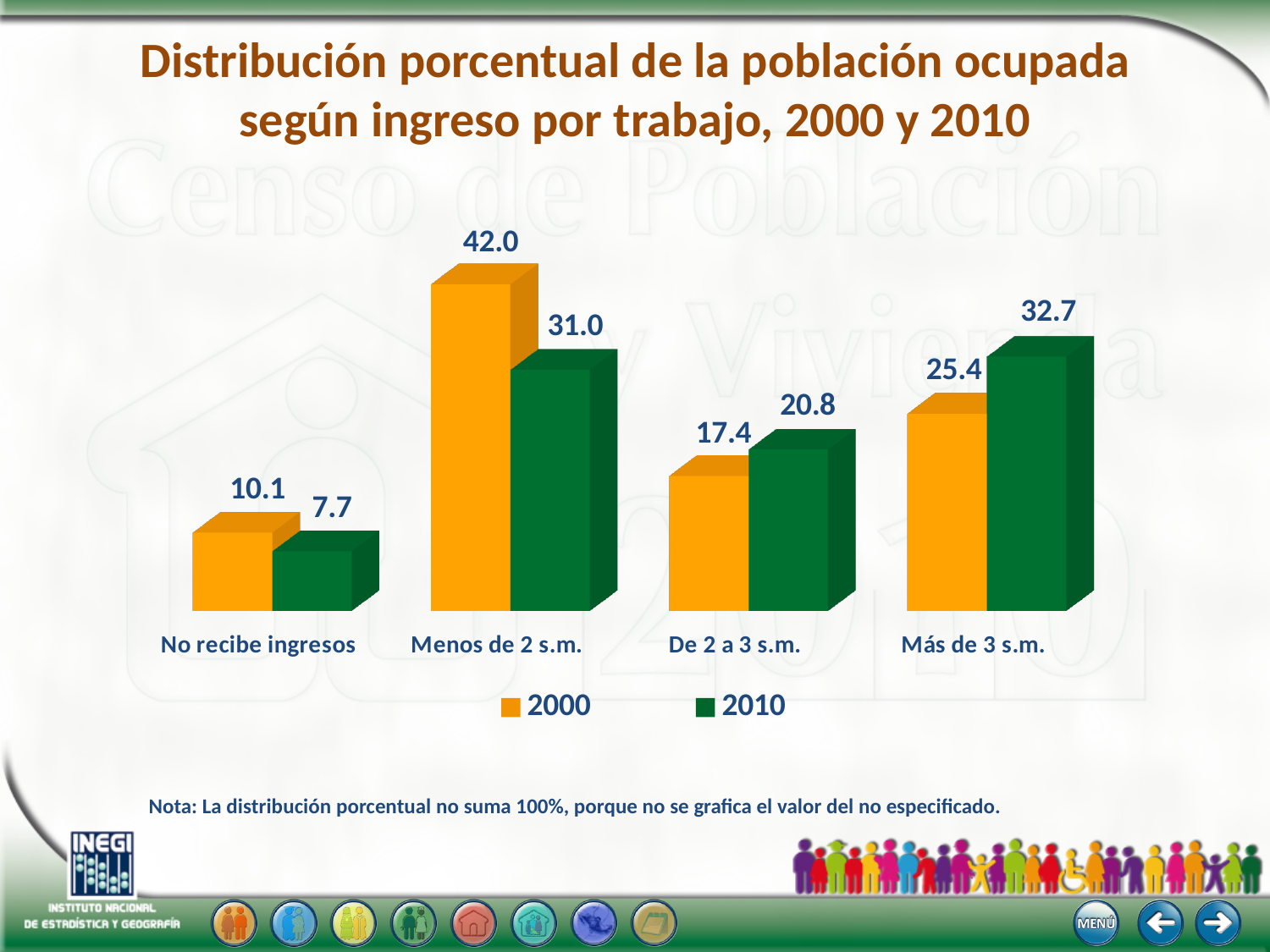
What is the value for 'De 2 a 3 s.m.' in the 2000 series? 17.4 Which is larger for 'Más de 3 s.m.': the 2000 value or the 2010 value? 2010 Which category has the highest value in the 2010 series? Más de 3 s.m. What is the difference between the 2000 and 2010 values for 'Menos de 2 s.m.'? 11.0 What kind of chart is shown on the slide? Bar chart What is the value for 'No recibe ingresos' in the 2010 series? 7.7 Which category has the lowest value in the 2000 series? No recibe ingresos What is the value for 'Más de 3 s.m.' in the 2010 series? 32.7 Which colour represents the 2010 series in the legend? Green How many series does the legend list? 2 What is the value for 'Menos de 2 s.m.' in the 2000 series? 42.0 How many categories are shown on the x axis? 4